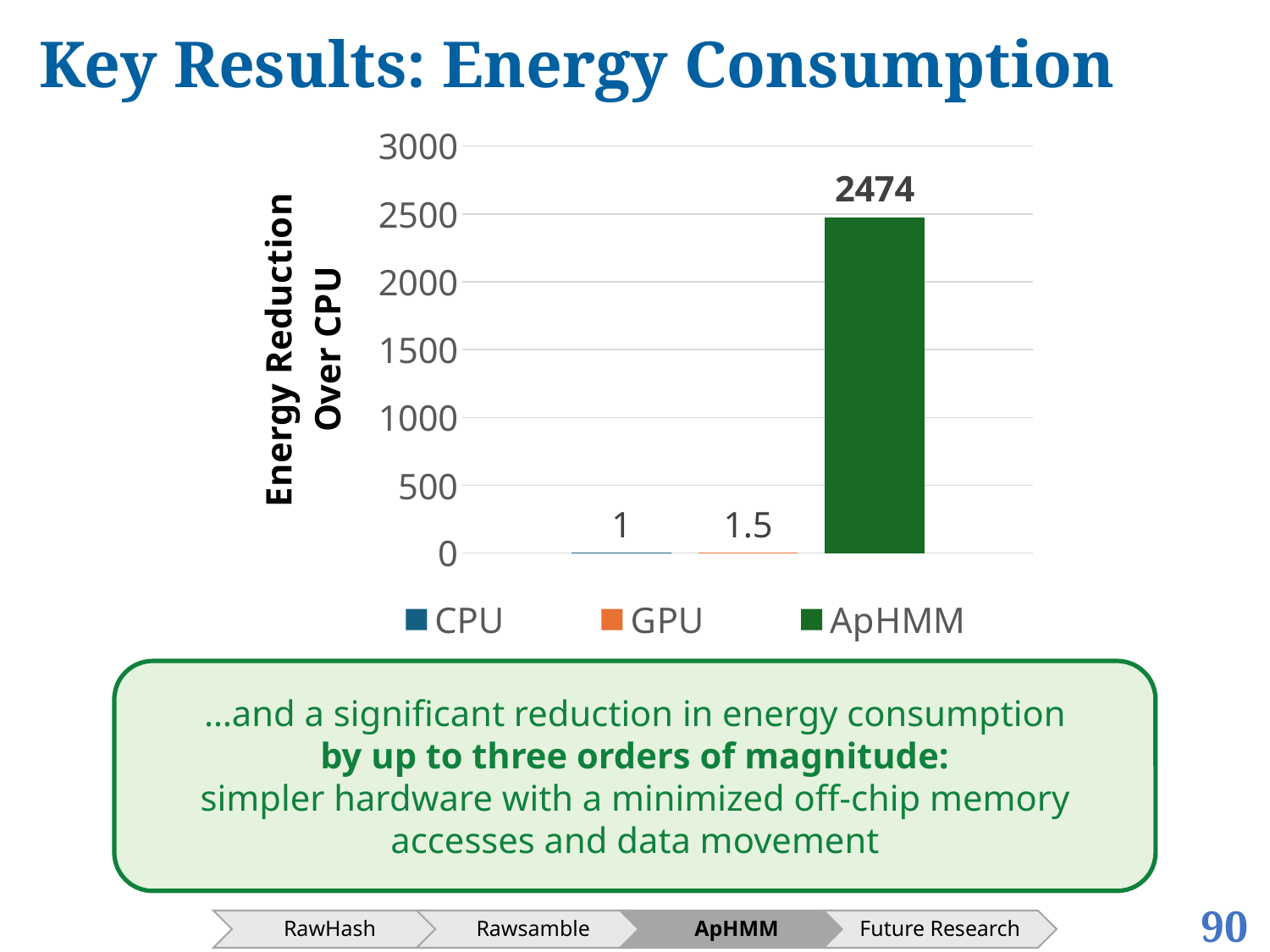
What is the energy reduction over CPU value for ApHMM? 2474 What colour is the ApHMM bar? green How many series does the legend list? 3 Which series has the highest energy reduction over CPU? ApHMM Which series has the lowest energy reduction over CPU? CPU Is the value for ApHMM greater or less than 2000? greater What kind of chart is shown on the slide? bar chart What is the energy reduction over CPU value for CPU? 1 Which is larger, the value for GPU or the value for CPU? GPU What is the energy reduction over CPU value for GPU? 1.5 What is the label of the vertical axis? Energy Reduction Over CPU What is the difference between the ApHMM and GPU values? 2472.5